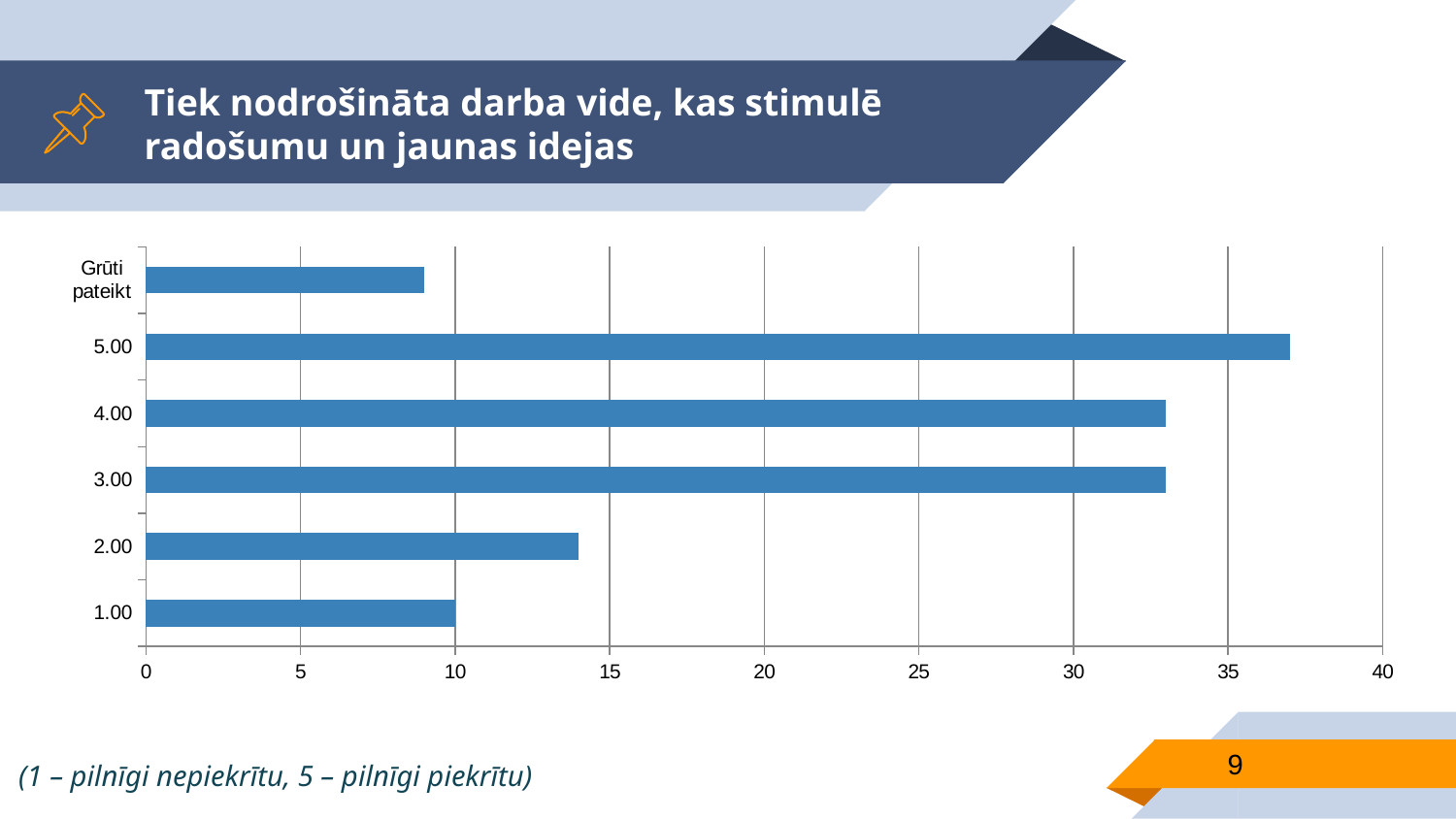
Which category has the highest value? 5.00 Is the value for 4.00 greater or less than 35? less Is the value for 3.00 greater or less than 30? greater What is the highest value shown on the horizontal axis? 40 Is the value for 5.00 greater or less than 35? greater What kind of chart is shown on the slide? bar chart Which has a larger value, 1.00 or 4.00? 4.00 How many categories are plotted on the chart? 6 Which has a larger value, 5.00 or 2.00? 5.00